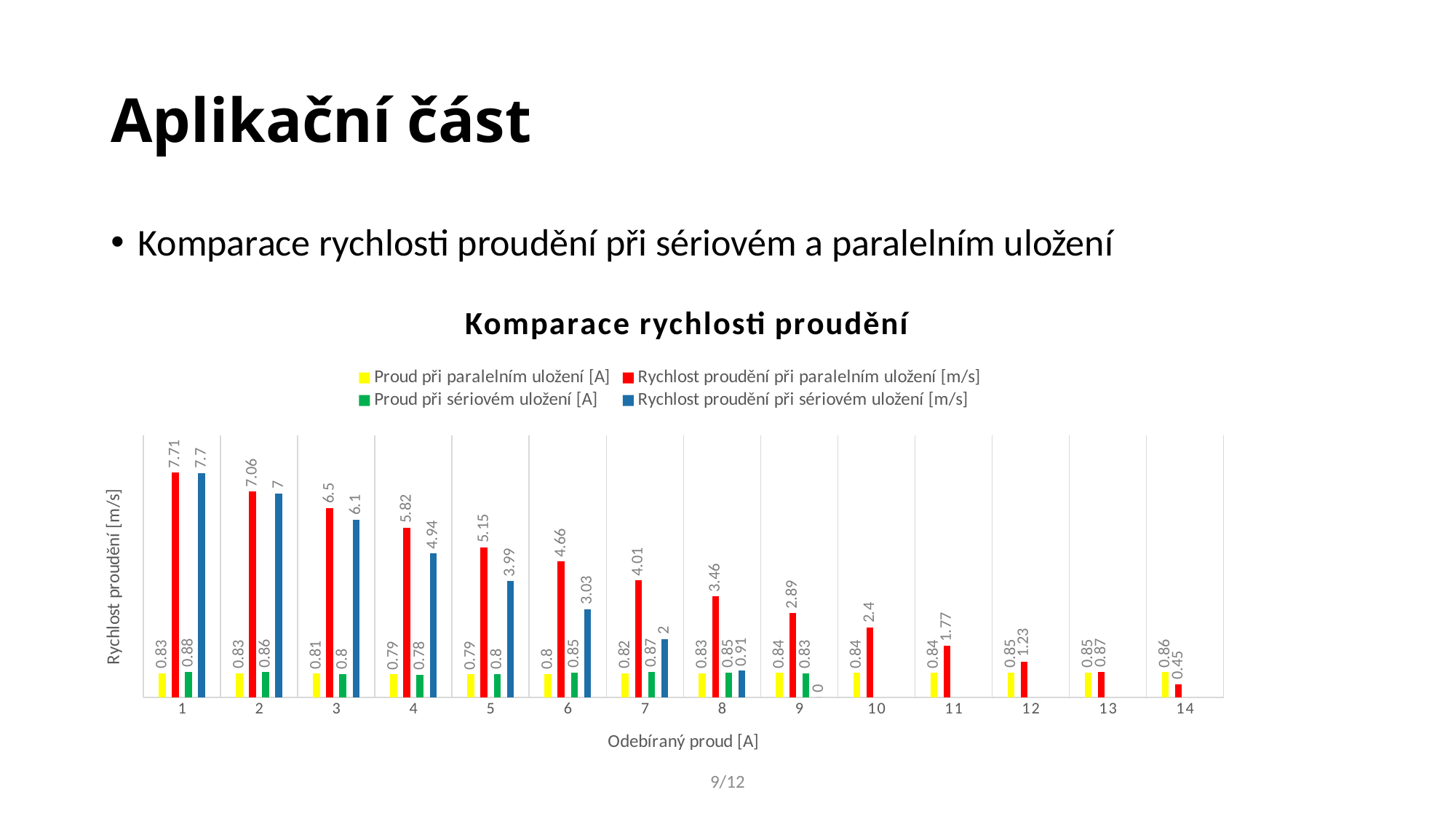
What is the difference between 'Rychlost proudění při paralelním uložení [m/s]' and 'Rychlost proudění při sériovém uložení [m/s]' at category 6? 1.63 What type of chart is shown on the slide? bar chart At which category is 'Rychlost proudění při paralelním uložení [m/s]' highest? 1 What is the value of 'Rychlost proudění při paralelním uložení [m/s]' at category 14? 0.45 At which category is 'Rychlost proudění při sériovém uložení [m/s]' lowest? 9 What is the value of 'Rychlost proudění při paralelním uložení [m/s]' at category 1? 7.71 What is the value of 'Proud při sériovém uložení [A]' at category 7? 0.87 Does 'Rychlost proudění při paralelním uložení [m/s]' rise or fall from category 1 to category 14? fall How many series does the legend list? 4 What is the value of 'Rychlost proudění při sériovém uložení [m/s]' at category 4? 4.94 At category 8, which is larger: 'Rychlost proudění při paralelním uložení [m/s]' or 'Rychlost proudění při sériovém uložení [m/s]'? Rychlost proudění při paralelním uložení [m/s] How many categories are shown on the x axis? 14